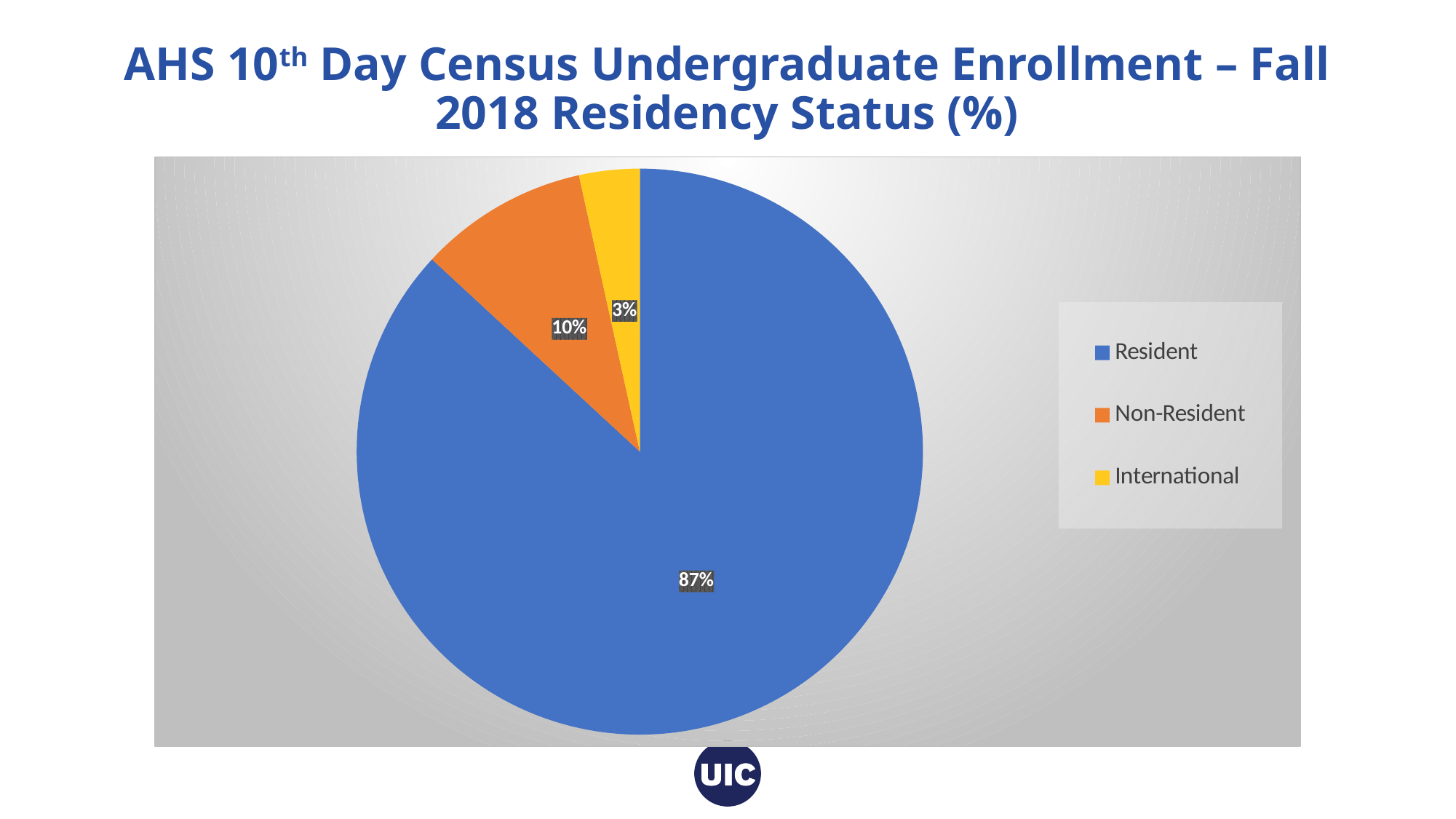
What is the difference in percentage points between the Non-Resident and International shares? 7 What colour represents the International slice? Yellow What percentage of undergraduate enrollment is Non-Resident? 10% Which is larger, the Non-Resident share or the International share? Non-Resident What is the title of the chart? AHS 10th Day Census Undergraduate Enrollment – Fall 2018 Residency Status (%) What percentage of undergraduate enrollment is Resident? 87% What kind of chart is shown on the slide? Pie chart What is the difference in percentage points between the Resident and Non-Resident shares? 77 Which residency status has the smallest share of the pie? International What percentage of undergraduate enrollment is International? 3% Which residency status has the largest share of the pie? Resident How many residency categories are shown in the pie chart? 3